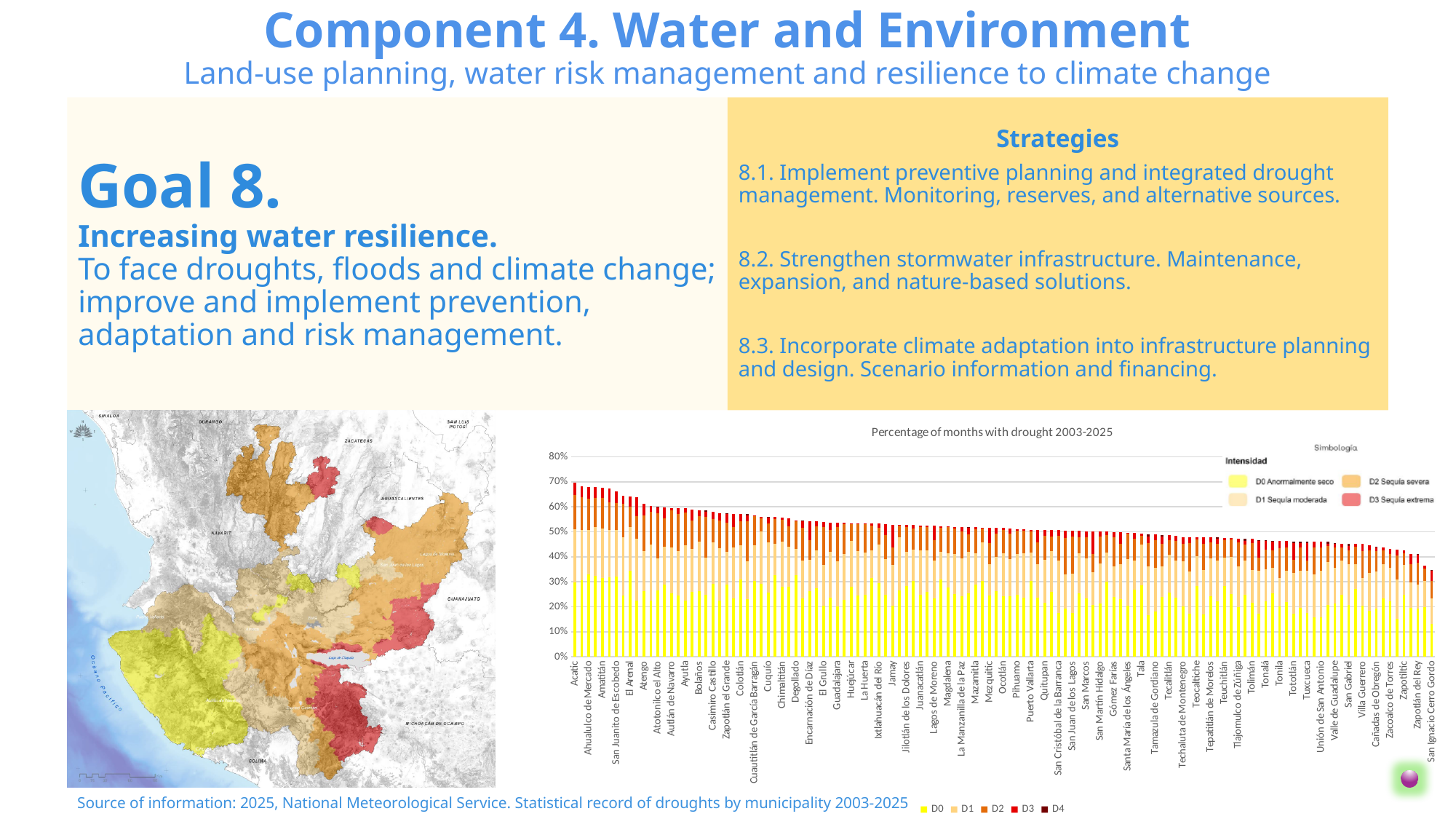
Is the total value for Tuxcueca in the drought chart greater or less than 40%? greater What kind of chart is shown at the bottom right of the slide? Stacked bar chart Is the total value for Guadalajara in the drought chart greater or less than 60%? less Which municipality has the lowest total percentage of months with drought in the chart? San Ignacio Cerro Gordo Is the total value for San Ignacio Cerro Gordo in the drought chart greater or less than 40%? less Which municipality has the highest total percentage of months with drought in the chart? Acatic In the drought chart, do the total bar heights rise or fall from left to right along the x axis? Fall In the drought chart, which has the larger total value: Acatic or San Ignacio Cerro Gordo? Acatic How many series does the legend of the drought chart list? 5 What is the highest value shown on the y axis of the drought chart? 80% What is the title of the chart at the bottom right of the slide? Percentage of months with drought 2003-2025